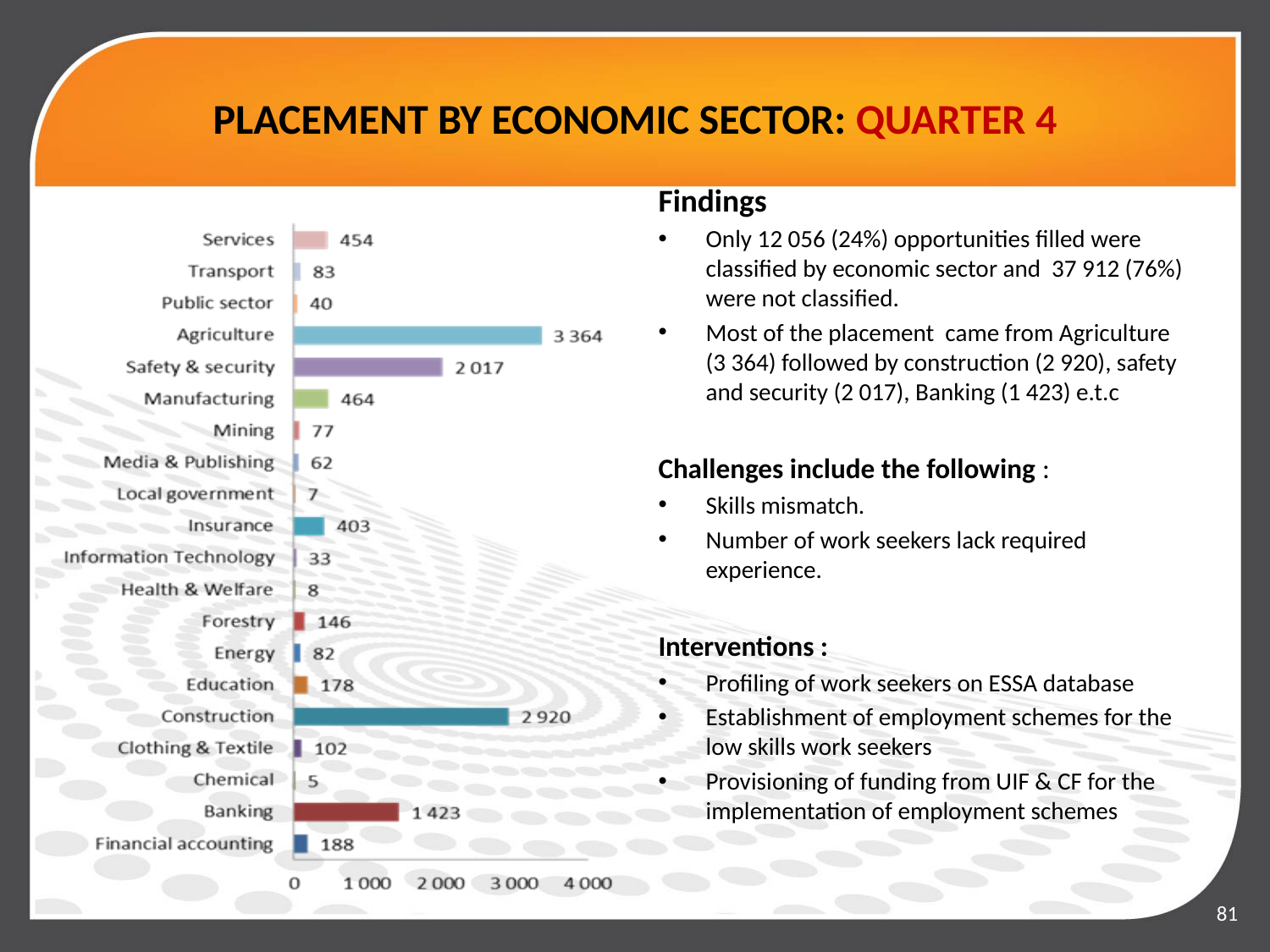
What is the placement value for Financial accounting? 188 Which has a larger placement value, Safety & security or Banking? Safety & security How many economic sectors are shown in the chart? 20 Which economic sector has the lowest placement value? Chemical Which economic sector has the highest placement value? Agriculture What is the title of the slide containing the chart? PLACEMENT BY ECONOMIC SECTOR: QUARTER 4 What is the difference between the placement values for Agriculture and Construction? 444 What is the placement value for Agriculture? 3 364 What is the placement value for Insurance? 403 What is the placement value for Banking? 1 423 What kind of chart is shown on the slide? Bar chart Is the value for Construction greater or less than 2 000? greater